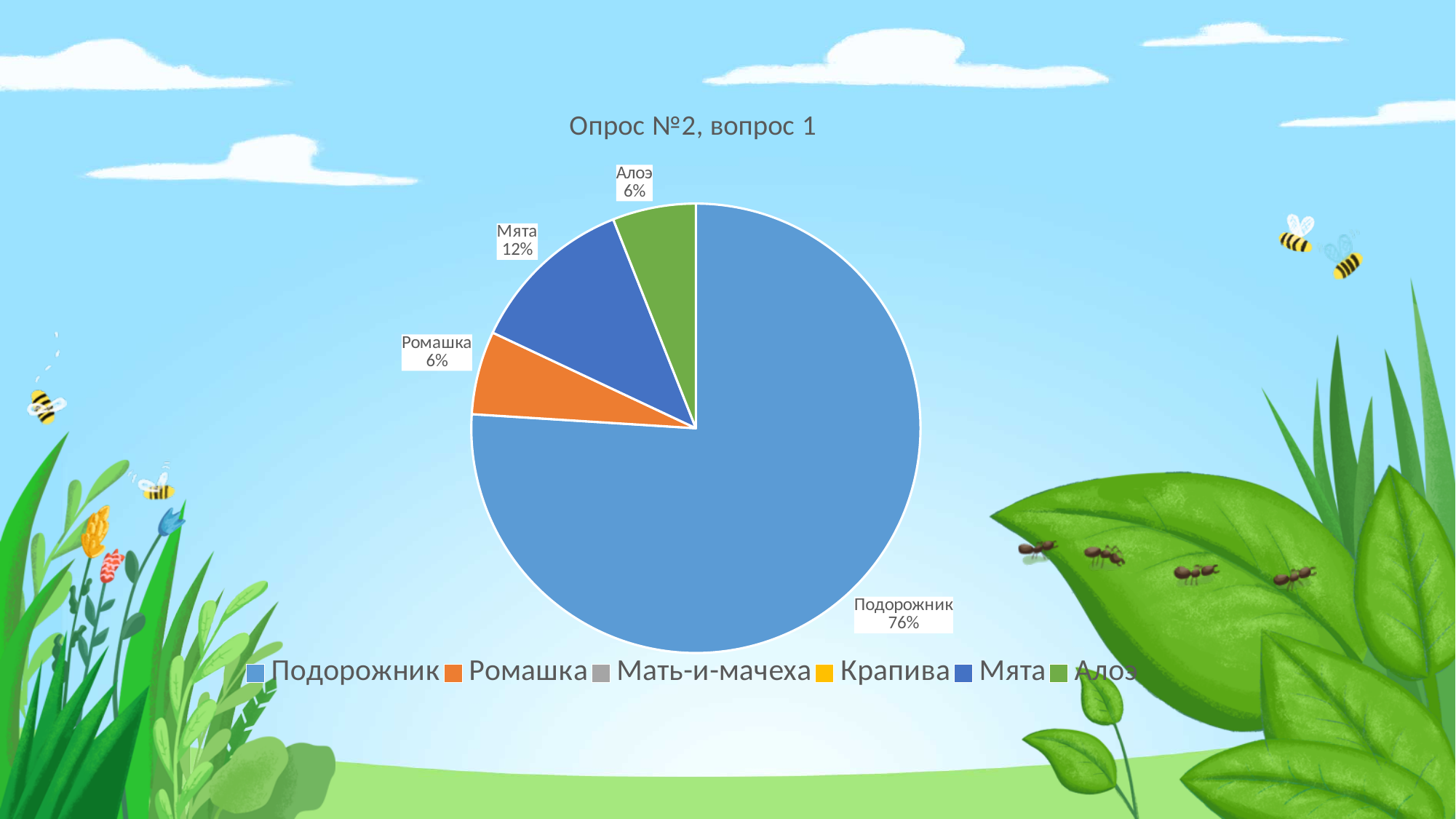
Which is larger, the slice for Мята or the slice for Ромашка? Мята How many slices with labels are visible in the pie? 4 What share of the pie does Подорожник have? 76% What percentage is shown for Ромашка? 6% What kind of chart is shown on the slide? pie chart How many entries does the legend list? 6 What share of the pie does Мята have? 12% Which category has the largest slice of the pie? Подорожник What is the difference in percentage points between Мята and Алоэ? 6 What percentage is shown for Алоэ? 6% What is the difference in percentage points between Подорожник and Мята? 64 What is the title of the chart? Опрос №2, вопрос 1